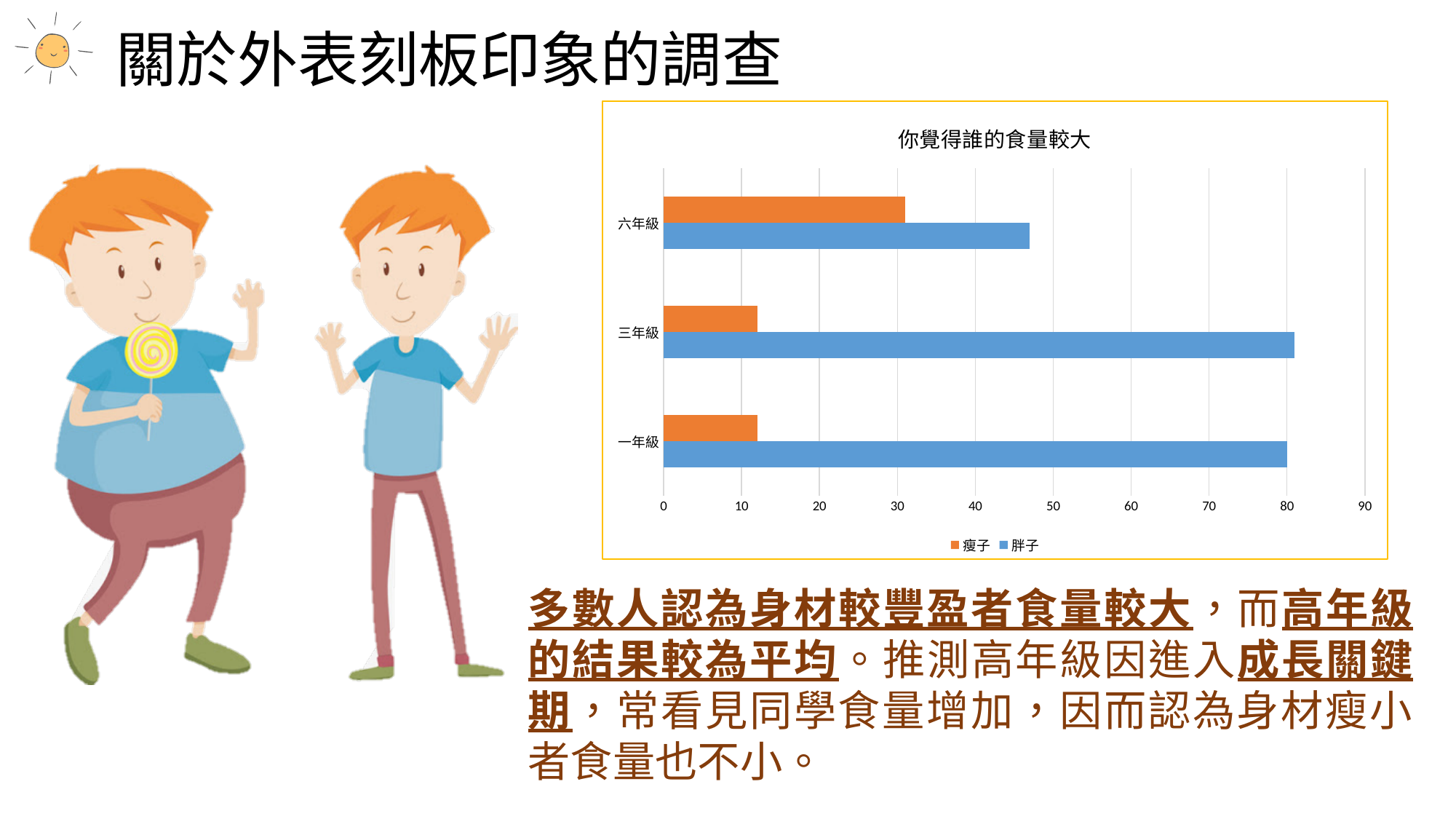
What is the title of the chart? 你覺得誰的食量較大 How many grade categories are shown on the chart? 3 Is the value for 瘦子 in 一年級 greater or less than 20? less What type of chart is shown on the slide? Bar chart Which series is shown in orange in the chart? 瘦子 For 六年級, which is larger: the value for 胖子 or the value for 瘦子? 胖子 Which grade has the highest value for 瘦子? 六年級 Which grade has the lowest value for 胖子? 六年級 Is the value for 胖子 in 六年級 greater or less than 40? greater Is the value for 瘦子 in 六年級 greater or less than 40? less How many series does the chart legend list? 2